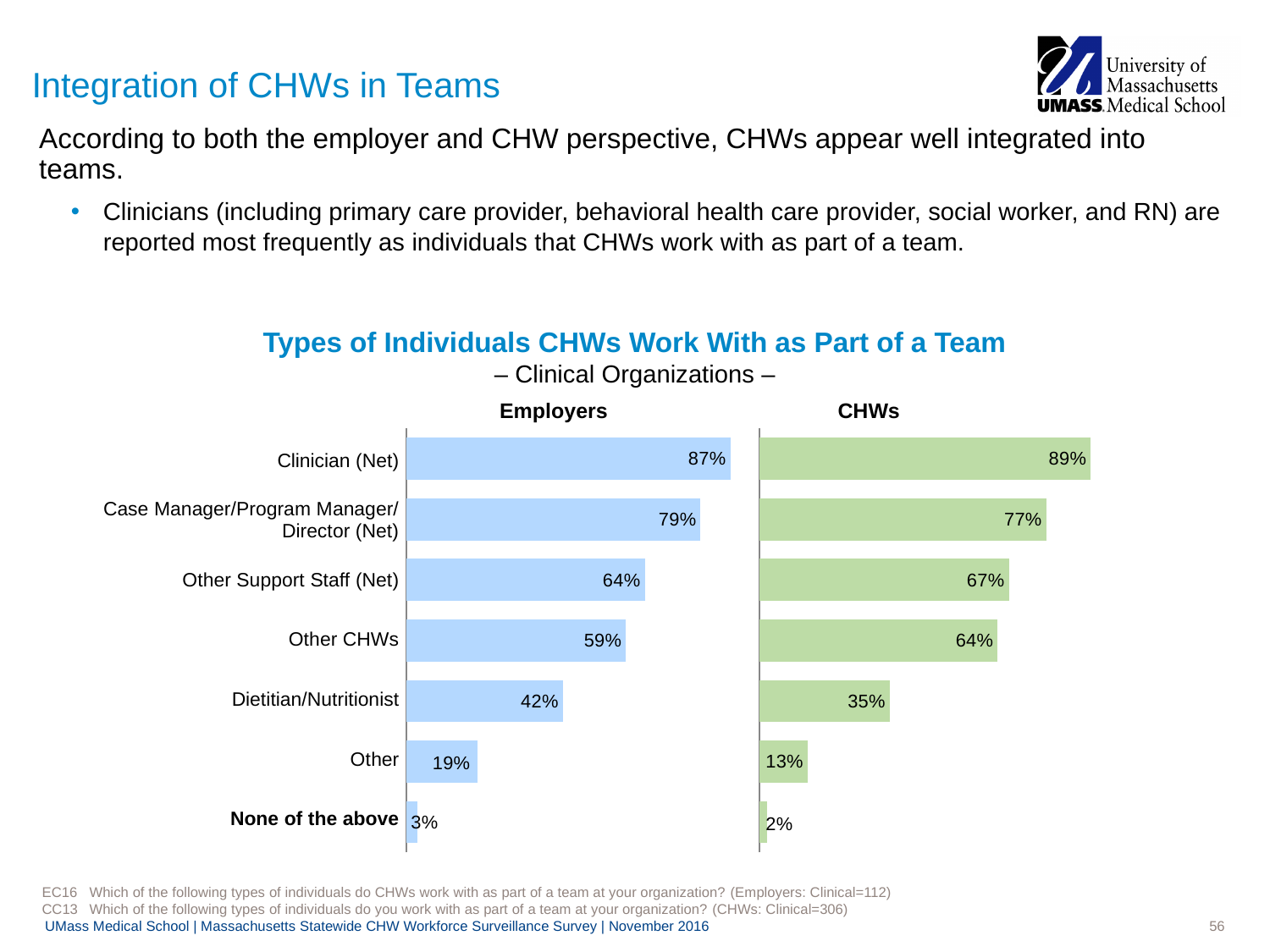
What is the difference between the Employers and CHWs values for Dietitian/Nutritionist? 7% In the Employers chart, which category has the highest value? Clinician (Net) How many categories are shown in the Employers chart? 7 What is the title of the chart on the slide? Types of Individuals CHWs Work With as Part of a Team – Clinical Organizations – In the Employers chart, what percentage is shown for Clinician (Net)? 87% For Case Manager/Program Manager/Director (Net), which is larger: the Employers value or the CHWs value? Employers What type of chart is used to show the Employers data? Bar chart In the Employers chart, what is the difference between Clinician (Net) and Other CHWs? 28% In the CHWs chart, what percentage is shown for Other Support Staff (Net)? 67% For Other Support Staff (Net), which is larger: the Employers value or the CHWs value? CHWs In the CHWs chart, what percentage is shown for Dietitian/Nutritionist? 35% In the CHWs chart, which category has the lowest value? None of the above